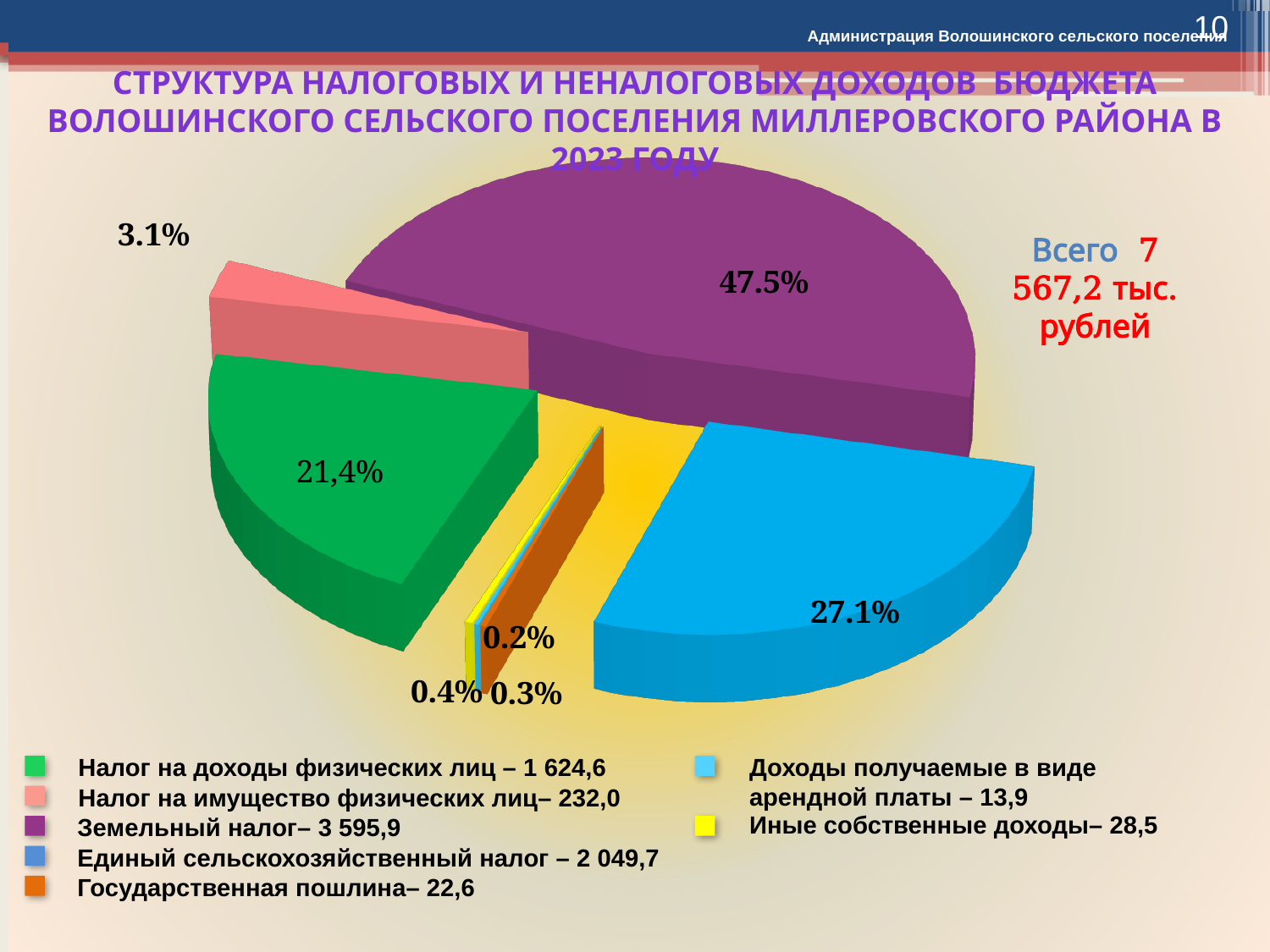
How many categories does the legend list? 7 What is the smallest percentage labelled on the pie? 0.2% What total amount is stated next to the pie chart? 7 567,2 тыс. рублей According to the legend, what is the value for Земельный налог? 3 595,9 Which category has the largest slice of the pie? Земельный налог According to the legend, what is the value for Единый сельскохозяйственный налог? 2 049,7 Which is larger: the share for Земельный налог or the share for Налог на доходы физических лиц? Земельный налог What percentage of the pie does Земельный налог (the purple slice) represent? 47.5% What type of chart is shown on the slide? pie chart According to the legend, what is the value for Государственная пошлина? 22,6 What percentage is shown for Налог на имущество физических лиц (the pink slice)? 3.1% What percentage is shown for the green slice, Налог на доходы физических лиц? 21,4%